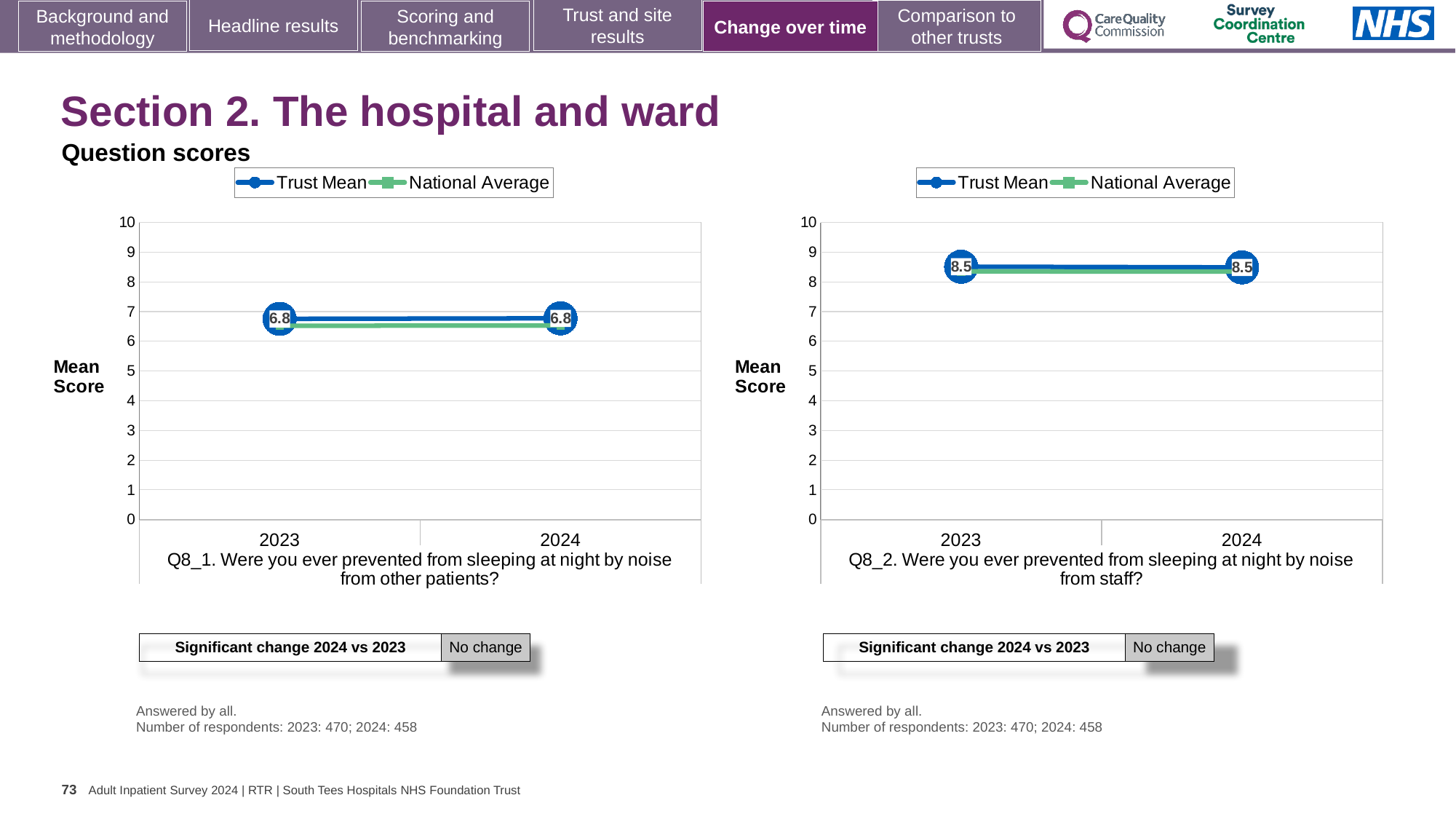
In the Q8_1 chart (left), what is the Trust Mean score for 2023? 6.8 In the Q8_1 chart (left), what is the Trust Mean score for 2024? 6.8 In the Q8_1 chart (left), what is the difference between the Trust Mean for 2024 and 2023? 0 What kind of chart is the Q8_1 chart (left)? line chart In the Q8_2 chart (right), what is the Trust Mean score for 2023? 8.5 In the Q8_2 chart (right), is the National Average for 2023 greater or less than 8? greater In the Q8_2 chart (right), which series is shown in green in the legend? National Average In the Q8_1 chart (left), is the National Average for 2024 greater or less than 7? less In the Q8_2 chart (right), does the Trust Mean rise, fall or stay the same from 2023 to 2024? stays the same How many series does the legend of the Q8_2 chart (right) list? 2 In the Q8_2 chart (right), what is the Trust Mean score for 2024? 8.5 How many years are plotted on the x axis of the Q8_1 chart (left)? 2